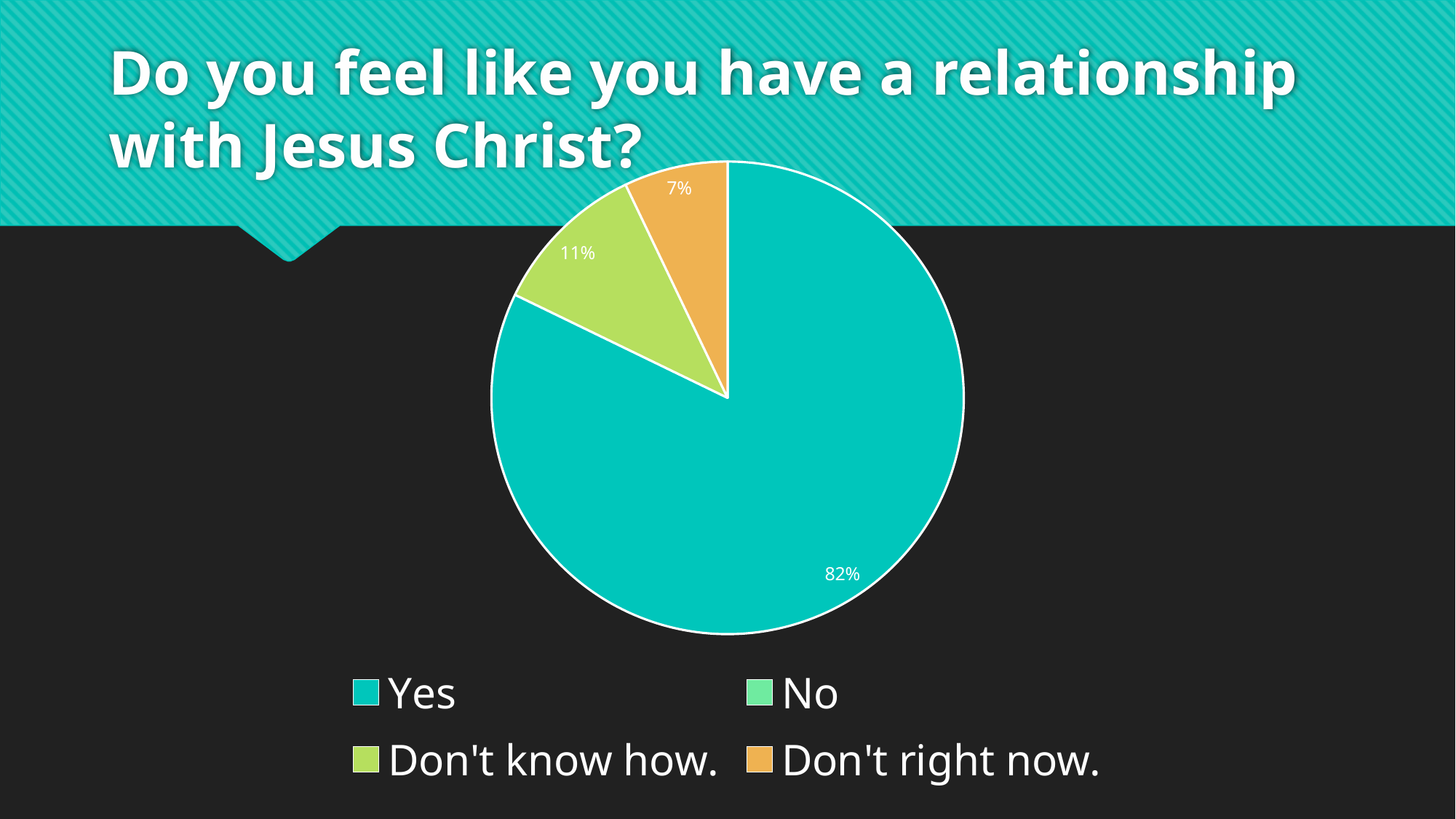
Which response has the largest share of the pie? Yes What colour is the "Yes" slice of the pie? Teal Which is larger, the share for "Don't know how." or the share for "Don't right now."? Don't know how. What is the difference in percentage points between "Don't know how." and "Don't right now."? 4 What percentage of respondents answered "Yes"? 82% Which labelled slice has the smallest share of the pie? Don't right now. What is the difference in percentage points between "Yes" and "Don't know how."? 71 What percentage of respondents answered "Don't know how."? 11% What is the title of the slide containing the chart? Do you feel like you have a relationship with Jesus Christ? What percentage of respondents answered "Don't right now."? 7% How many entries does the legend list? 4 What kind of chart is shown on the slide? Pie chart